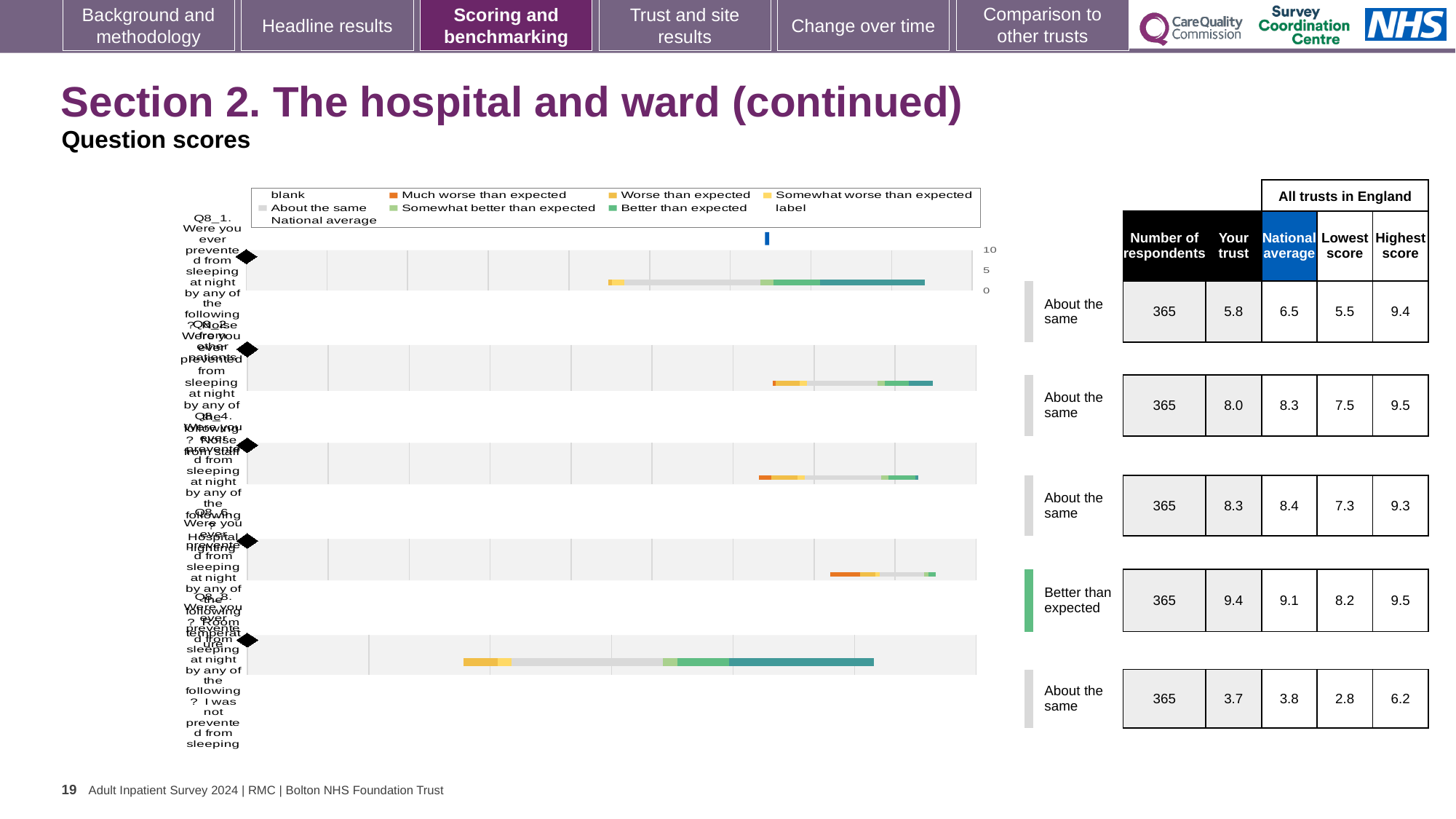
How many respondents are listed for each question row in the table? 365 Which question row in the chart is rated 'Better than expected'? The fourth row (Q8_6) What kind of chart is shown on the slide? Bar chart For the fourth row (Q8_6), which is larger: the 'Your trust' score or the national average? Your trust Which row has the highest 'Your trust' score in the table? The fourth row (Q8_6), 9.4 How many question rows (bars) are plotted in the chart? 5 How many of the question rows are rated 'About the same'? 4 For the first row (Q8_1), what is the difference between the national average and the 'Your trust' score? 0.7 In the table beside the chart, what is the 'Your trust' score for the first row (Q8_1)? 5.8 Which row has the lowest 'Your trust' score in the table? The fifth row (Q8_8), 3.7 What is the highest score across all trusts in England for the fifth row (Q8_8)? 6.2 In the table beside the chart, what is the national average for the fourth row (Q8_6)? 9.1